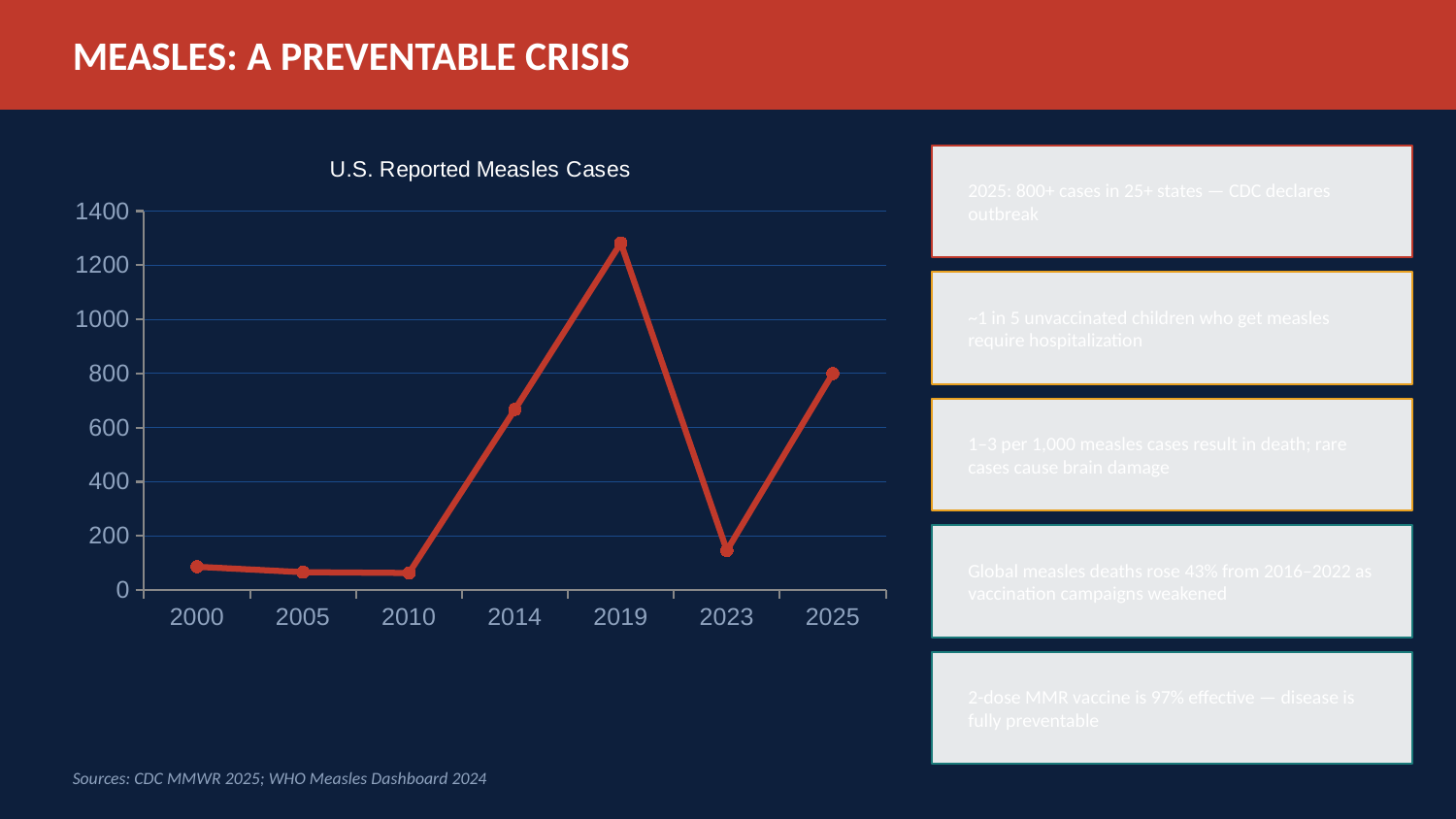
Is the value for 2014 greater or less than 600? greater Which year has the highest number of reported measles cases? 2019 What kind of chart is shown on the slide? Line chart Is the value for 2023 greater or less than 200? less Is the value for 2019 greater or less than 1200? greater Do reported cases rise or fall between 2010 and 2019? Rise How many years are plotted on the x axis of the chart? 7 Which year has more reported cases, 2014 or 2023? 2014 What is the title of the chart? U.S. Reported Measles Cases Do reported cases rise or fall between 2019 and 2023? Fall